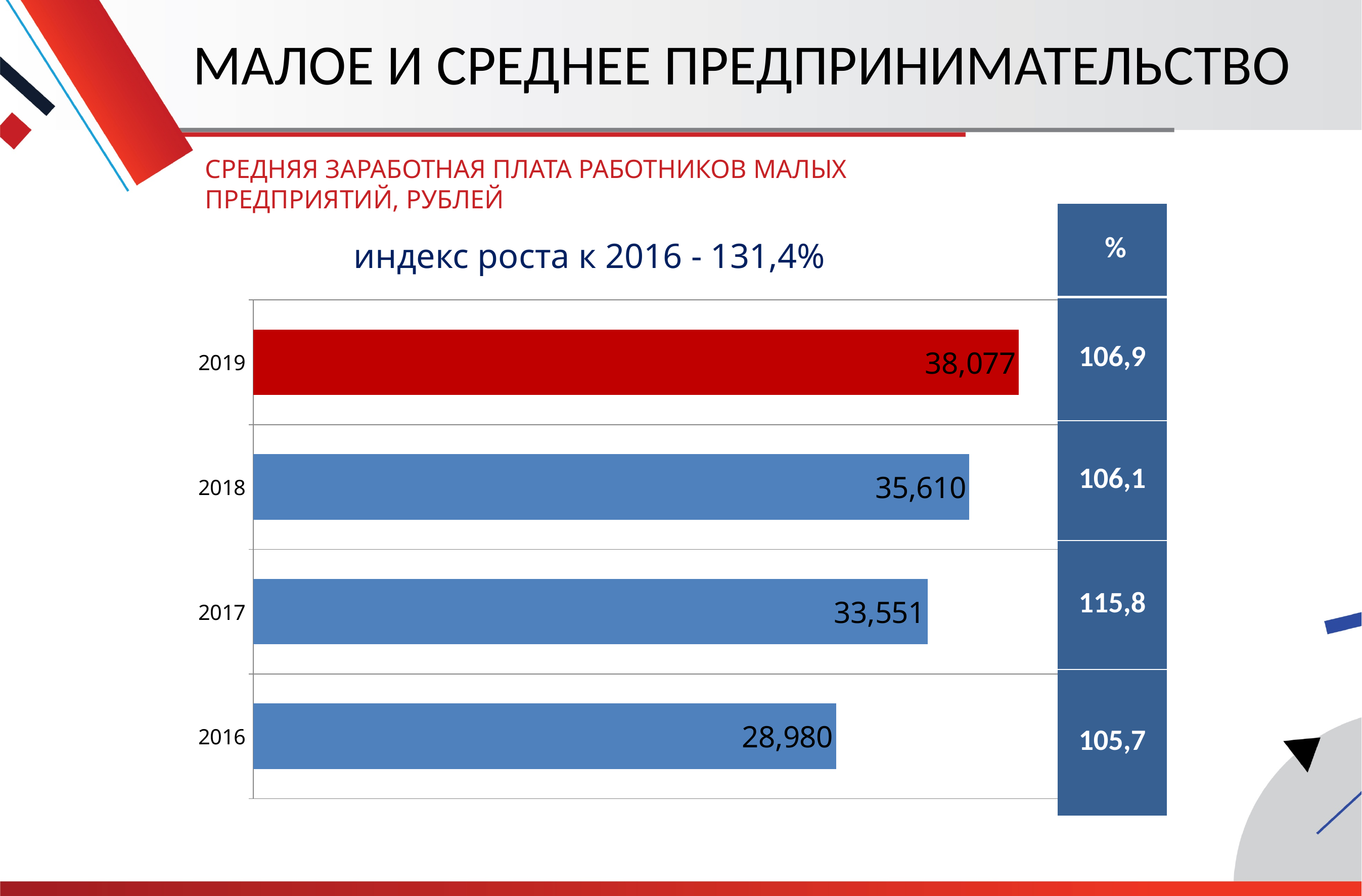
What is the value shown for 2017? 33,551 What is the difference between the values for 2019 and 2018? 2,467 Which year has the highest average wage? 2019 What is the value of the bar for 2016? 28,980 Which year has the lowest average wage? 2016 Which is larger, the value for 2017 or the value for 2018? 2018 How many years are shown in the chart? 4 What kind of chart is shown on the slide? bar chart Do the average wage values rise or fall from 2016 to 2019? rise What percentage is shown in the % column next to 2017? 115,8 What is the difference between the values for 2019 and 2016? 9,097 What is the average wage value shown for 2019? 38,077